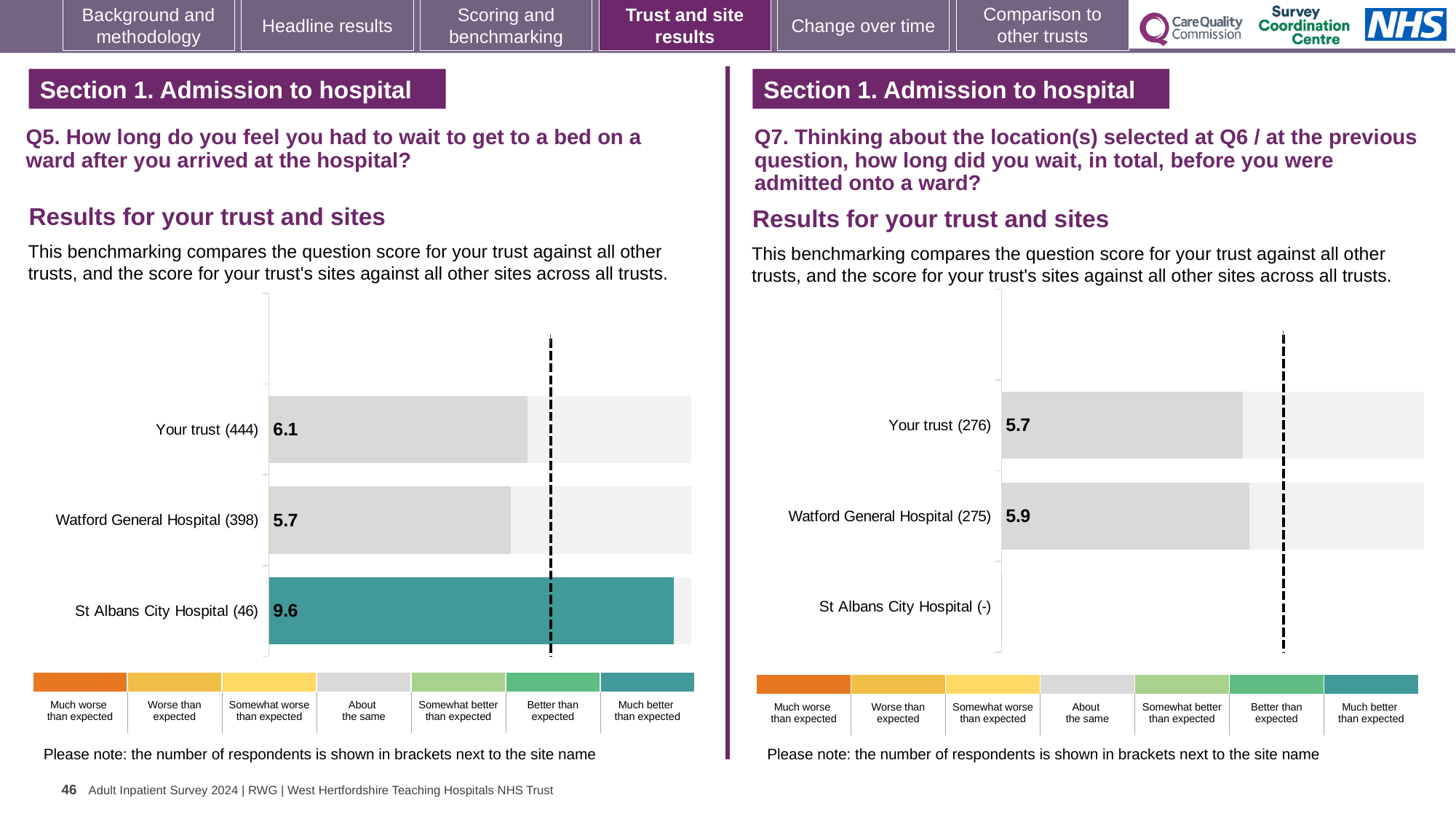
On the right chart (Q7), what is the score for Your trust (276)? 5.7 On the right chart (Q7), which has the larger score, Your trust or Watford General Hospital? Watford General Hospital On the right chart (Q7), what is the difference between the scores for Watford General Hospital and Your trust? 0.2 How many categories (trust and sites) are listed on the left chart (Q5)? 3 On the left chart (Q5), which site or trust has the highest score? St Albans City Hospital (46) On the left chart (Q5), what is the score for St Albans City Hospital (46)? 9.6 On the left chart (Q5), what is the score for Watford General Hospital (398)? 5.7 On the left chart (Q5), what is the score for Your trust (444)? 6.1 On the right chart (Q7), what is the score for Watford General Hospital (275)? 5.9 On the left chart (Q5), which site or trust has the lowest score? Watford General Hospital (398) What kind of chart is used on the left (Q5)? Bar chart On the left chart (Q5), what is the difference between the scores for St Albans City Hospital and Your trust? 3.5